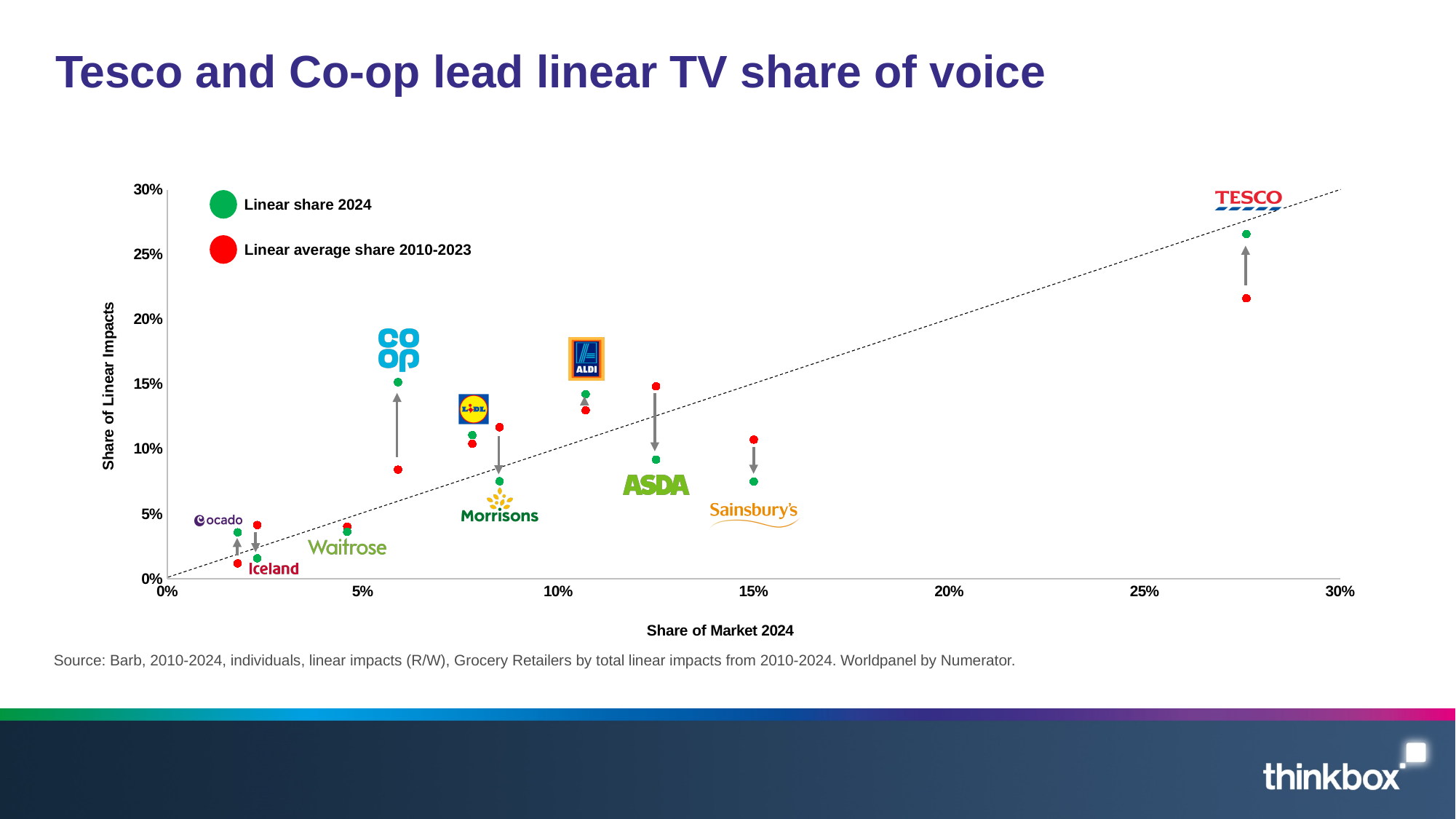
Is Tesco's linear share 2024 greater or less than 25%? greater Is Co-op's linear share 2024 greater or less than 10%? greater Which retailer has the highest linear share in 2024? Tesco How many retailers are plotted on the chart? 10 How many series does the legend list? 2 Which has the larger linear share 2024: Co-op or Lidl? Co-op Is Asda's linear share 2024 greater or less than 10%? less What is the title of the x axis? Share of Market 2024 Which retailer has the lowest linear share in 2024? Iceland For Tesco, which is larger: the linear share 2024 or the linear average share 2010-2023? Linear share 2024 What kind of chart is shown on the slide? Scatter chart For Morrisons, which is larger: the linear share 2024 or the linear average share 2010-2023? Linear average share 2010-2023